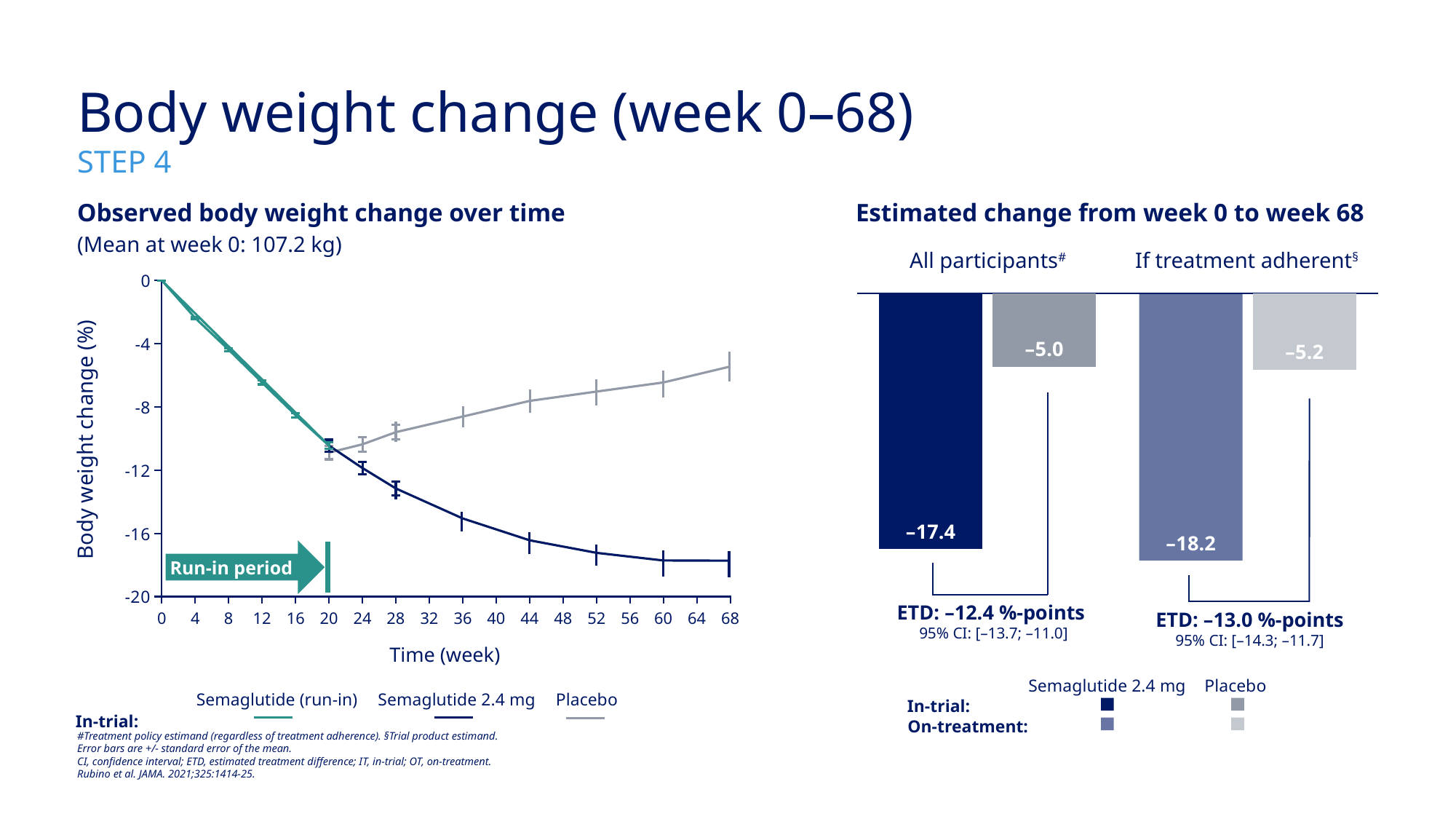
In the 'Estimated change from week 0 to week 68' chart, how many bars are plotted? 4 In the 'Observed body weight change over time' chart, does the Placebo line rise or fall from week 20 to week 68? Rises In the 'Estimated change from week 0 to week 68' chart, what is the value for Placebo among all participants? –5.0 In the 'Observed body weight change over time' chart, how many series does the legend list? 3 What kind of chart is 'Observed body weight change over time'? Line chart In the 'Estimated change from week 0 to week 68' chart, what is the value for Semaglutide 2.4 mg among all participants? –17.4 In the 'Observed body weight change over time' chart, is the Semaglutide 2.4 mg value at week 68 greater or less than -16? less In the 'Estimated change from week 0 to week 68' chart, which bar shows the largest weight reduction? Semaglutide 2.4 mg, if treatment adherent (–18.2) In the 'Estimated change from week 0 to week 68' chart, what is the value for Semaglutide 2.4 mg if treatment adherent? –18.2 In the 'Estimated change from week 0 to week 68' chart, what is the value for Placebo if treatment adherent? –5.2 In the 'Estimated change from week 0 to week 68' chart, what is the ETD for all participants? –12.4 %-points In the 'Estimated change from week 0 to week 68' chart, what is the difference between the Semaglutide 2.4 mg and Placebo values for all participants? 12.4